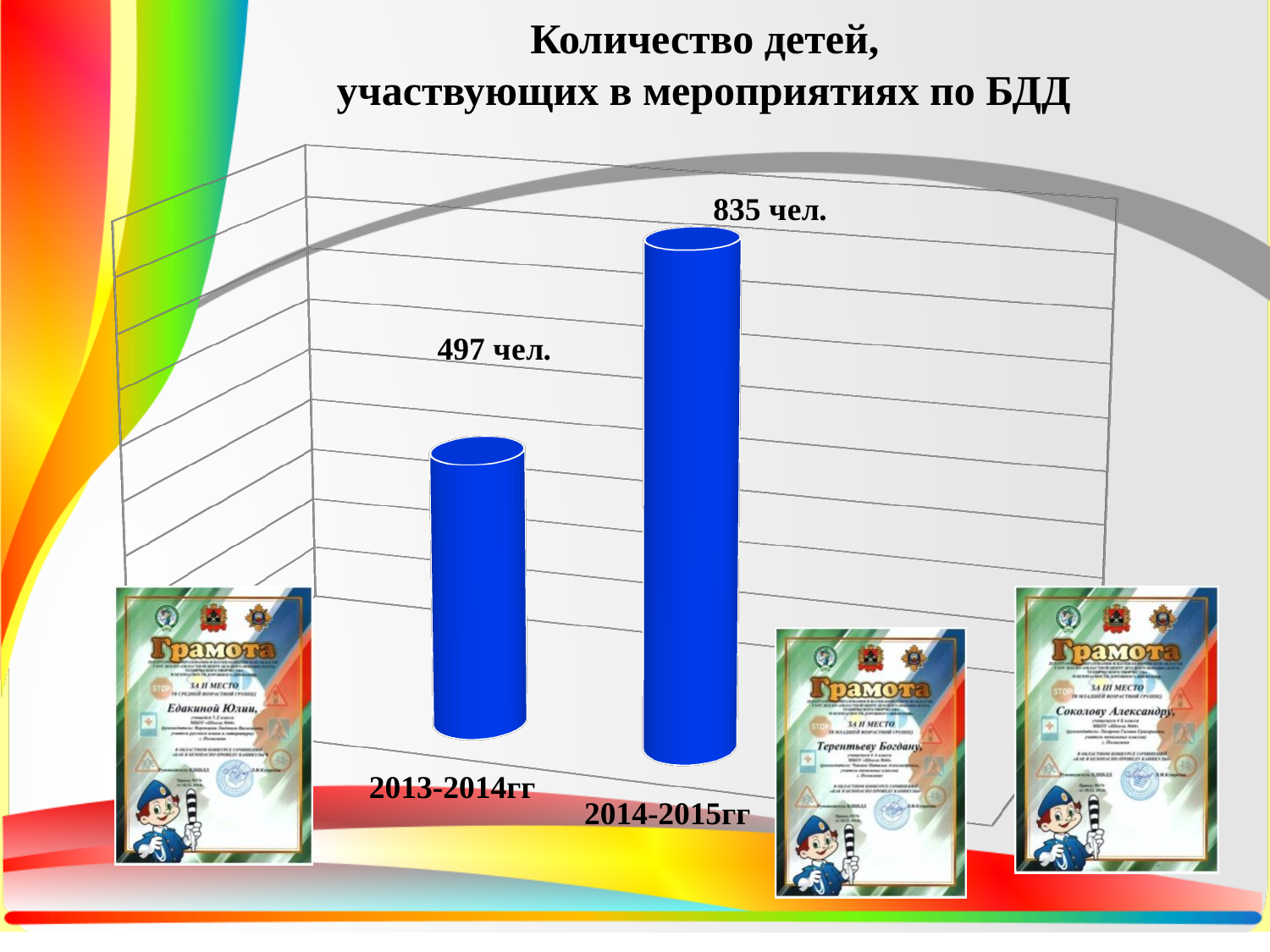
What is the value for 2014-2015гг? 835 чел. What is the difference between the values for 2014-2015гг and 2013-2014гг? 338 чел. Which period has the lowest number of children? 2013-2014гг What is the value for 2013-2014гг? 497 чел. What colour are the bars in the chart? Blue What is the title of the chart? Количество детей, участвующих в мероприятиях по БДД Do the values rise or fall from 2013-2014гг to 2014-2015гг? Rise Which is larger, the value for 2013-2014гг or the value for 2014-2015гг? 2014-2015гг What kind of chart is shown on the slide? Bar chart Which period has the highest number of children? 2014-2015гг How many categories are shown in the chart? 2